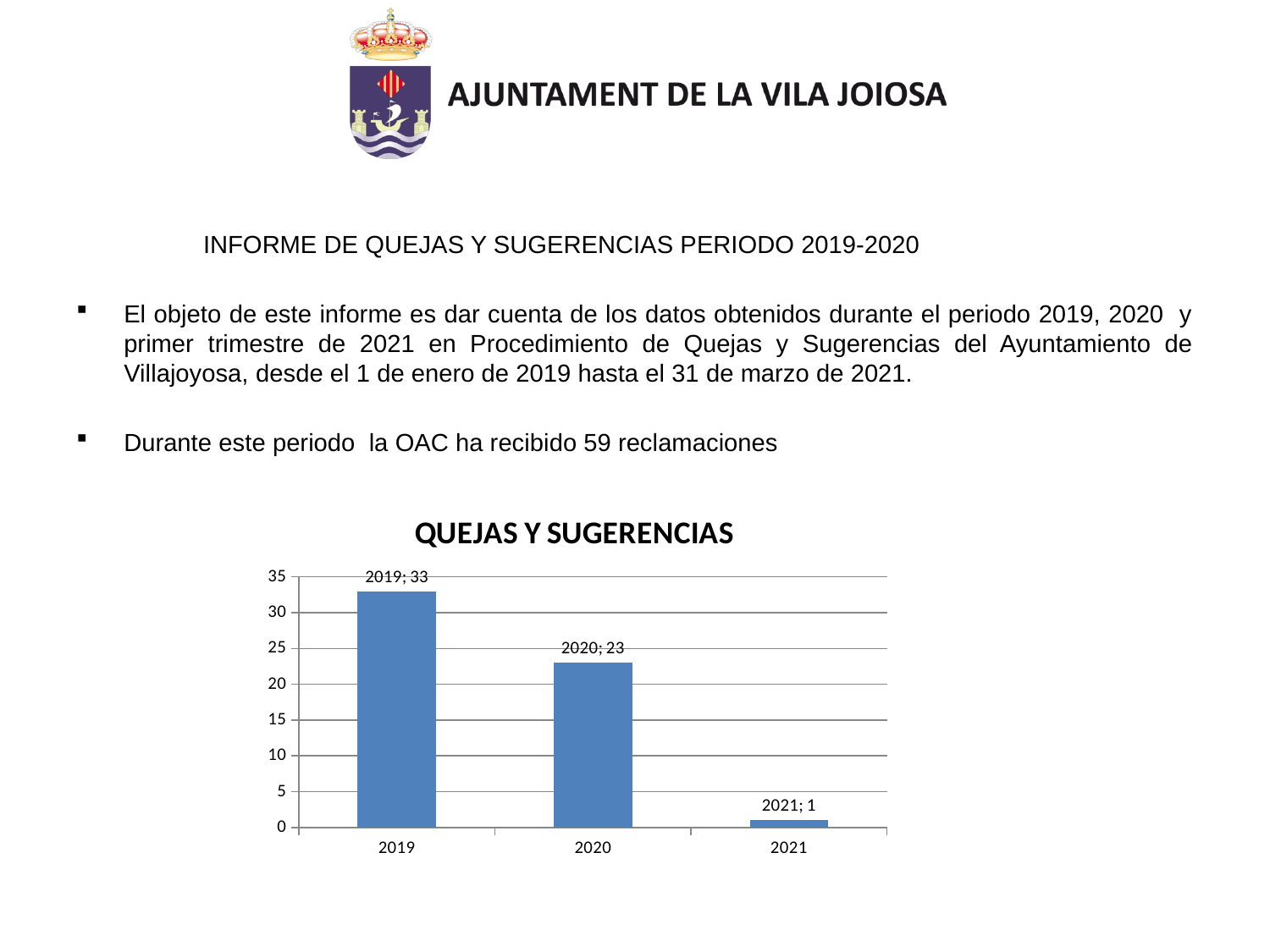
What is the value for 2021 in the chart? 1 What is the value for 2019 in the chart? 33 What is the value for 2020 in the chart? 23 Which is larger, the value for 2019 or the value for 2020? 2019 Which year has the lowest value in the chart? 2021 What is the title of the chart? QUEJAS Y SUGERENCIAS What kind of chart is shown on the slide? bar chart What is the difference between the values for 2020 and 2021? 22 How many categories are shown on the x axis of the chart? 3 Which year has the highest value in the chart? 2019 What is the difference between the values for 2019 and 2020? 10 Is the value for 2020 greater or less than 25? less